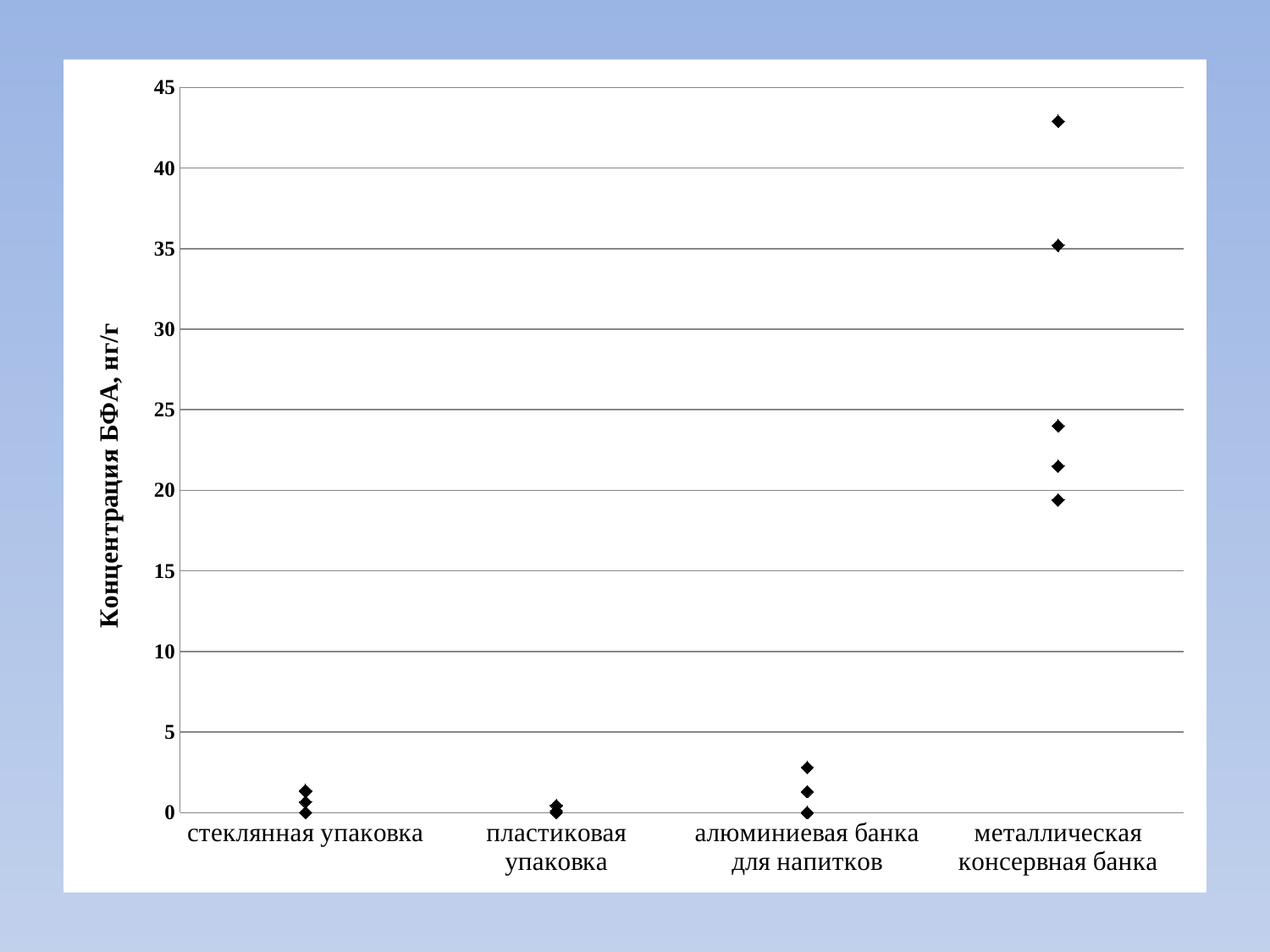
How many data points are plotted for металлическая консервная банка? 5 Are all values for стеклянная упаковка greater or less than 5? less Is the highest value for алюминиевая банка для напитков greater or less than 5? less What is the label of the y axis? Концентрация БФА, нг/г Which has higher values: металлическая консервная банка or пластиковая упаковка? металлическая консервная банка Is the lowest value for металлическая консервная банка greater or less than 15? greater What kind of chart is shown on the slide? scatter chart Which packaging category has the highest BPA concentration values? металлическая консервная банка How many packaging categories are shown on the x axis? 4 What is the maximum value shown on the y axis? 45